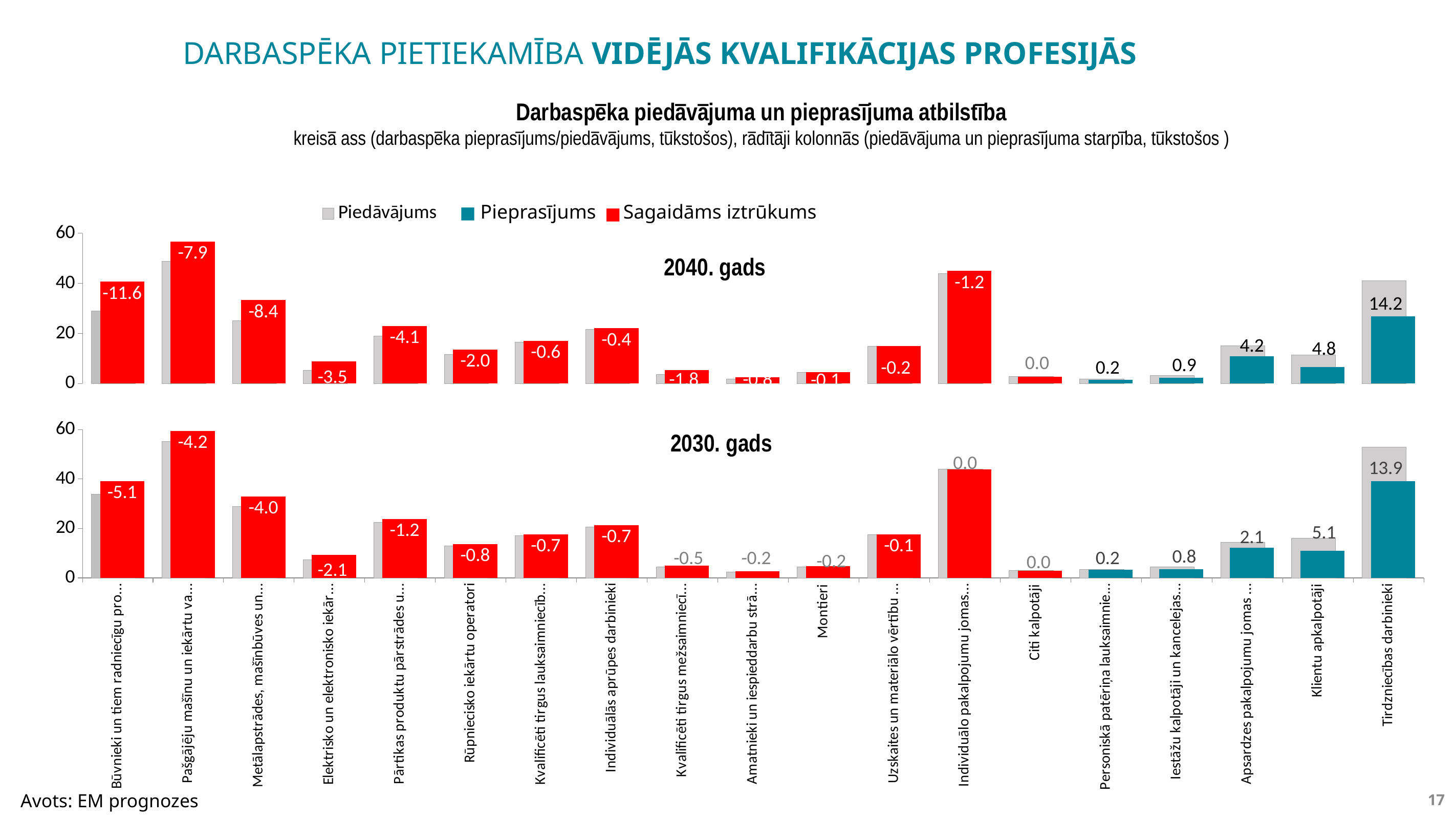
On the 2030. gads chart, what is the data label for Klientu apkalpotāji? 5.1 On the 2030. gads chart, is the Pieprasījums value for Tirdzniecības darbinieki greater or less than 20? greater On the 2040. gads chart, what is the data label for Tirdzniecības darbinieki? 14.2 On the 2040. gads chart, what is the data label for Montieri? -0.1 How many series does the legend list? 3 Is the data label for Klientu apkalpotāji larger on the 2030. gads chart or on the 2040. gads chart? 2030. gads On the 2040. gads chart, which category has the highest data label? Tirdzniecības darbinieki On the 2030. gads chart, what is the data label for Tirdzniecības darbinieki? 13.9 On the 2030. gads chart, what is the data label for Rūpniecisko iekārtu operatori? -0.8 On the 2040. gads chart, what is the data label for Klientu apkalpotāji? 4.8 What kind of chart is the 2030. gads chart? bar chart On the 2040. gads chart, what is the difference between the data labels for Tirdzniecības darbinieki and Klientu apkalpotāji? 9.4